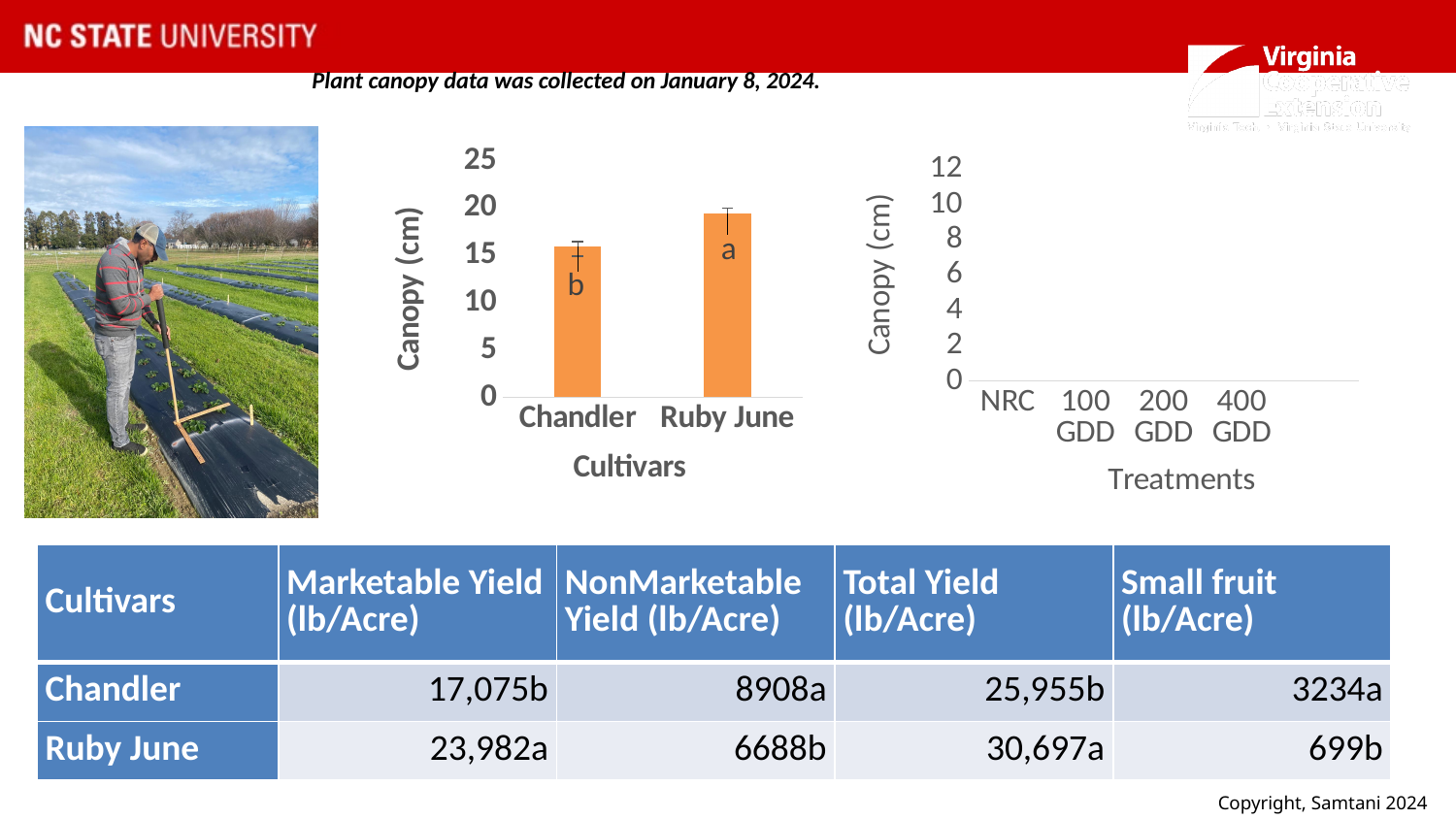
In the right chart (Treatments), what is the highest value shown on the y-axis? 12 In the left chart (Cultivars), is the canopy value for Chandler greater or less than 10? greater In the left chart (Cultivars), which cultivar has the highest canopy value? Ruby June In the left chart (Cultivars), how many cultivars are plotted? 2 In the left chart (Cultivars), is the canopy value for Ruby June larger or smaller than that for Chandler? larger In the left chart (Cultivars), what is the y-axis label? Canopy (cm) In the left chart (Cultivars), which cultivar has the lowest canopy value? Chandler In the left chart (Cultivars), is the canopy value for Ruby June greater or less than 25? less What kind of chart is the left chart with the x-axis labelled Cultivars? bar chart In the right chart (Treatments), how many treatment categories are shown on the x-axis? 4 In the left chart (Cultivars), what letter is printed on the Chandler bar? b